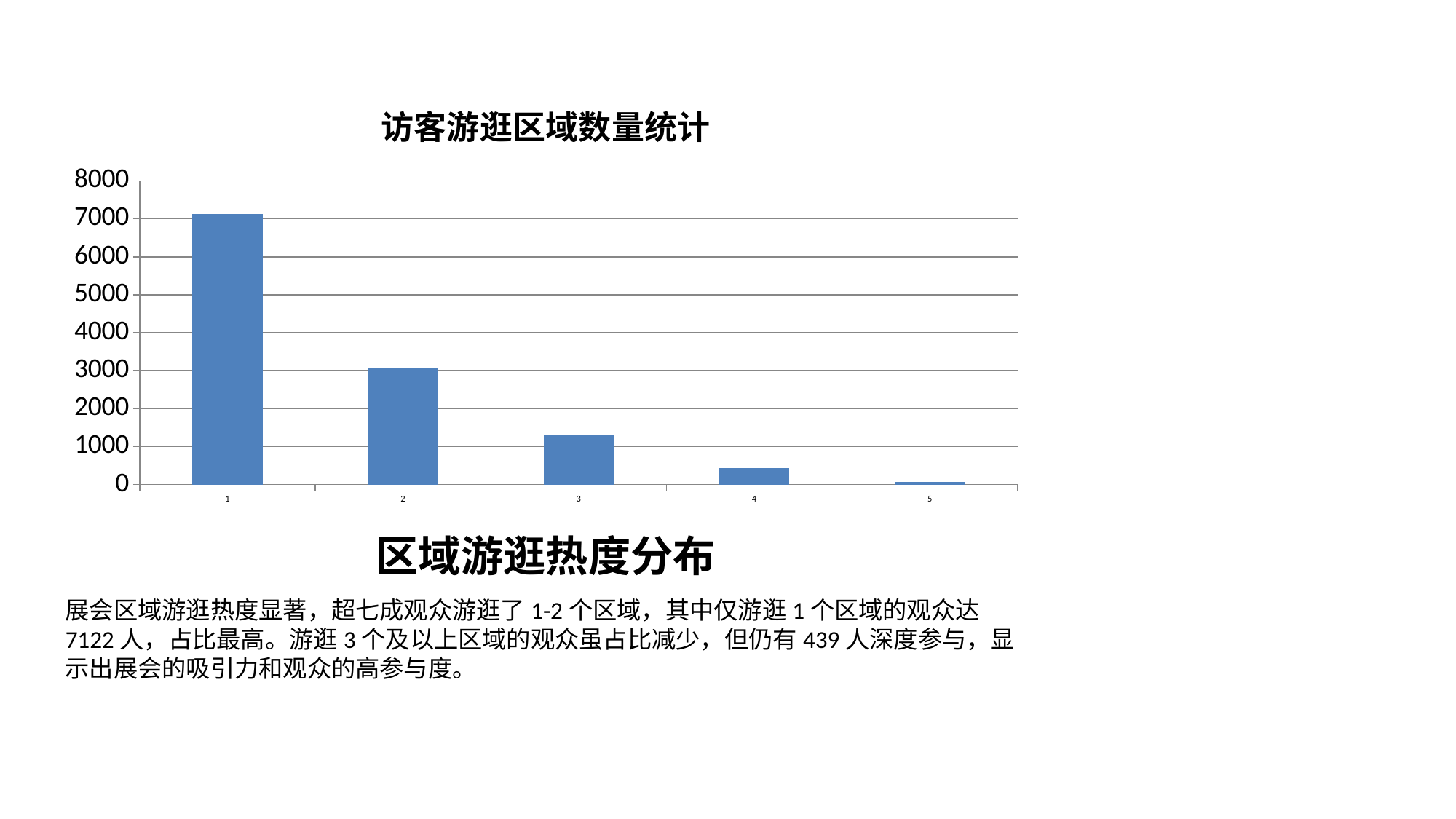
Is the value for category 4 greater or less than 1000? less Is the value for category 2 greater or less than 4000? less Is the value for category 3 greater or less than 1000? greater Which is larger, the value for category 2 or the value for category 3? category 2 Which category has the highest bar in the chart? 1 Which category has the lowest bar in the chart? 5 What kind of chart is shown on the slide? bar chart Do the values rise or fall as you move from category 1 to category 5 along the x axis? fall What is the highest value shown on the y axis of the chart? 8000 How many categories are shown on the x axis of the chart? 5 What is the title of the chart? 访客游逛区域数量统计